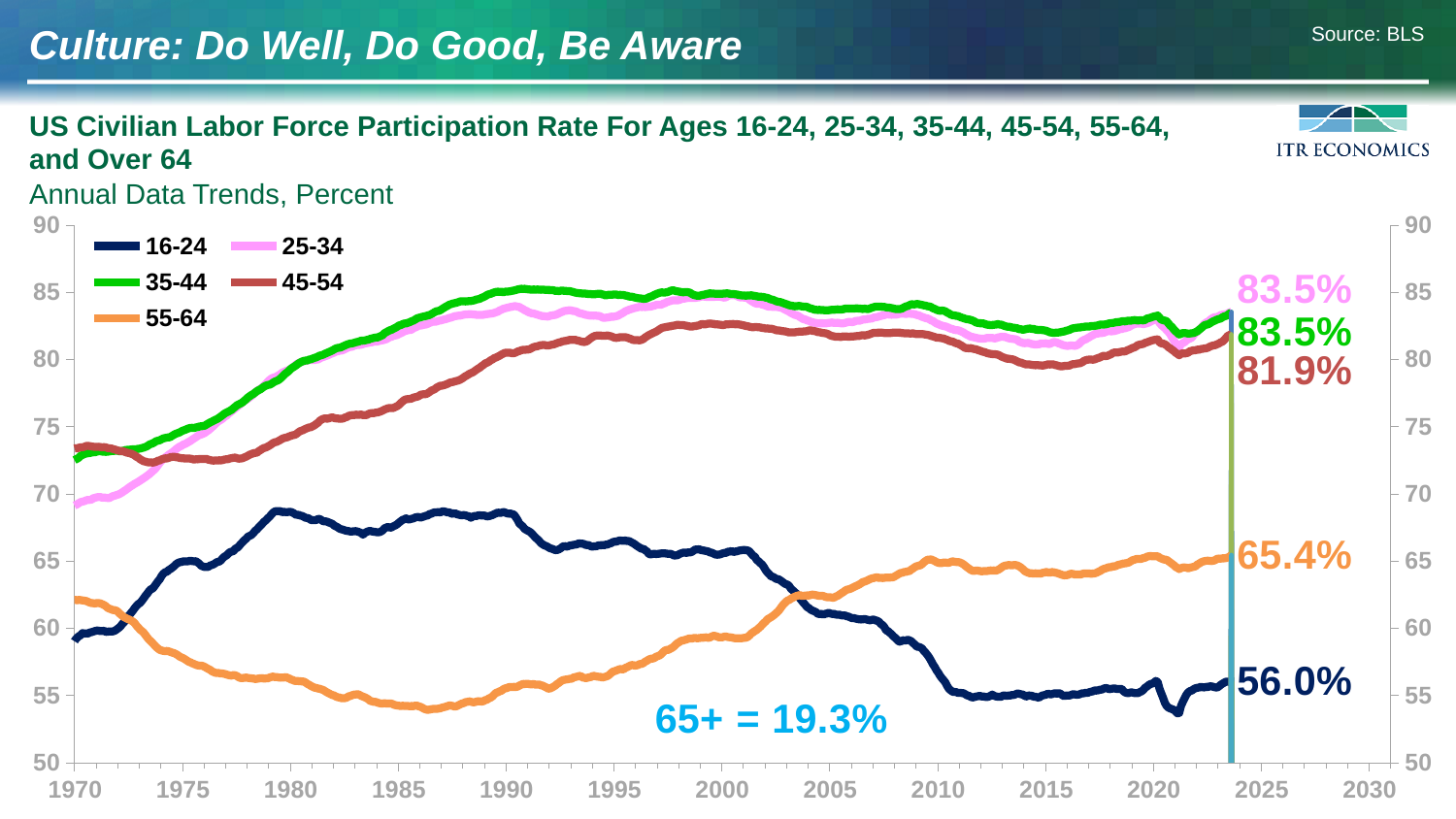
What kind of chart is shown on the slide? Line chart Which plotted age group has the lowest latest labeled value? 16-24 Which has the higher latest labeled value, the 55-64 group or the 16-24 group? 55-64 What is the latest labeled value for the 16-24 age group? 56.0% Is the value for the 16-24 group in 1990 greater or less than 65? greater Does the 55-64 line rise or fall between 1990 and 2023? Rises What is the latest labeled value for the 45-54 age group? 81.9% What is the latest labeled value for the 55-64 age group? 65.4% How many series does the legend list? 5 What labor force participation rate does the slide give for the 65+ group? 19.3% What is the difference between the latest labeled values for the 55-64 and 16-24 age groups? 9.4 percentage points What is the difference between the latest labeled values for the 35-44 and 45-54 age groups? 1.6 percentage points